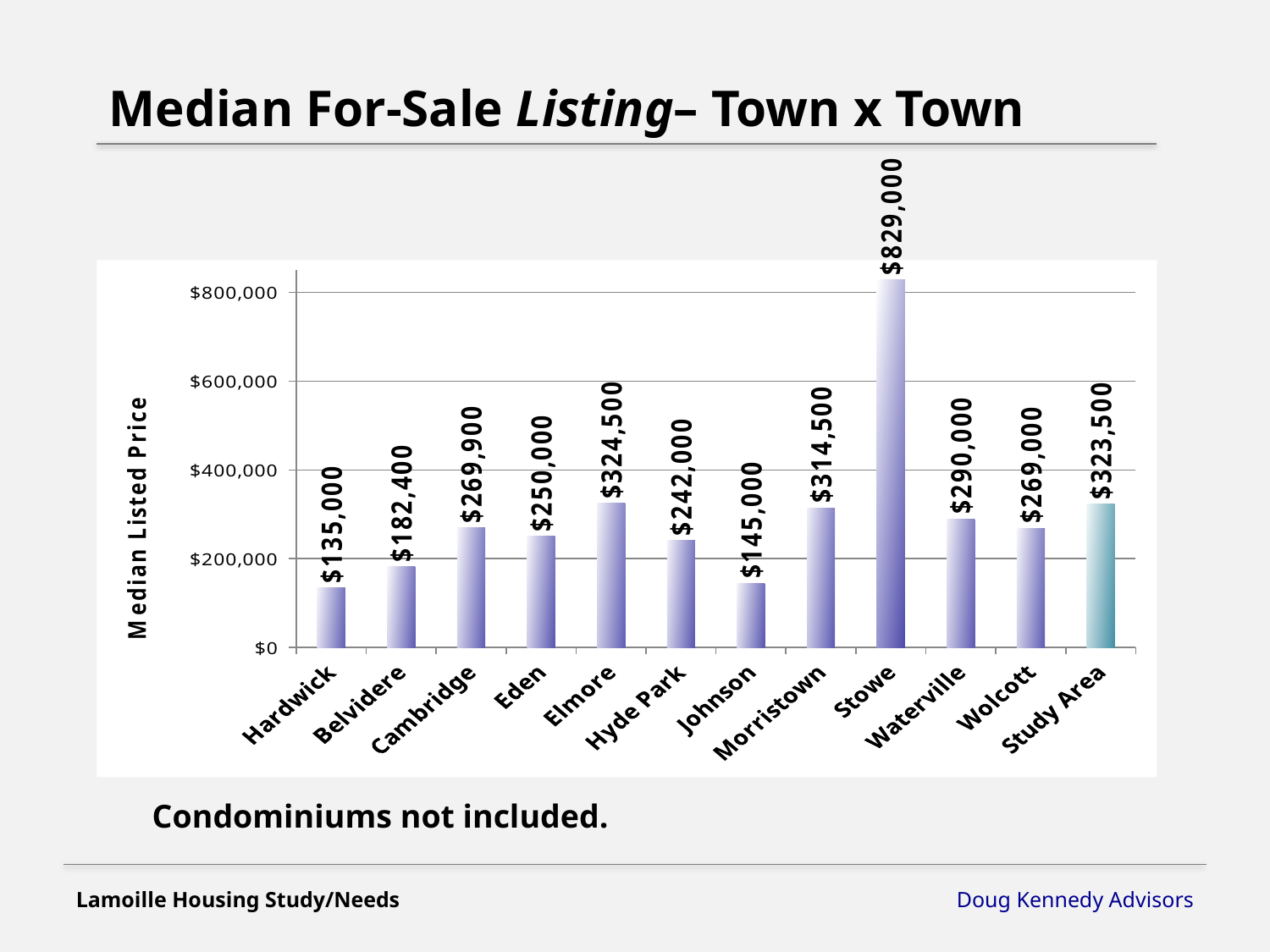
Which town has the lowest median listed price? Hardwick What is the median listed price for the Study Area? $323,500 What is the difference between the median listed price in Belvidere and in Hardwick? $47,400 What is the difference between the median listed price in Stowe and in Elmore? $504,500 Which town has the highest median listed price? Stowe What is the median listed price for Hardwick? $135,000 How many categories are shown on the x axis? 12 What is the label of the y axis? Median Listed Price Which has a higher median listed price, Morristown or Waterville? Morristown What kind of chart is shown on the slide? bar chart Is the median listed price for Johnson greater or less than $200,000? less What is the median listed price for Stowe? $829,000